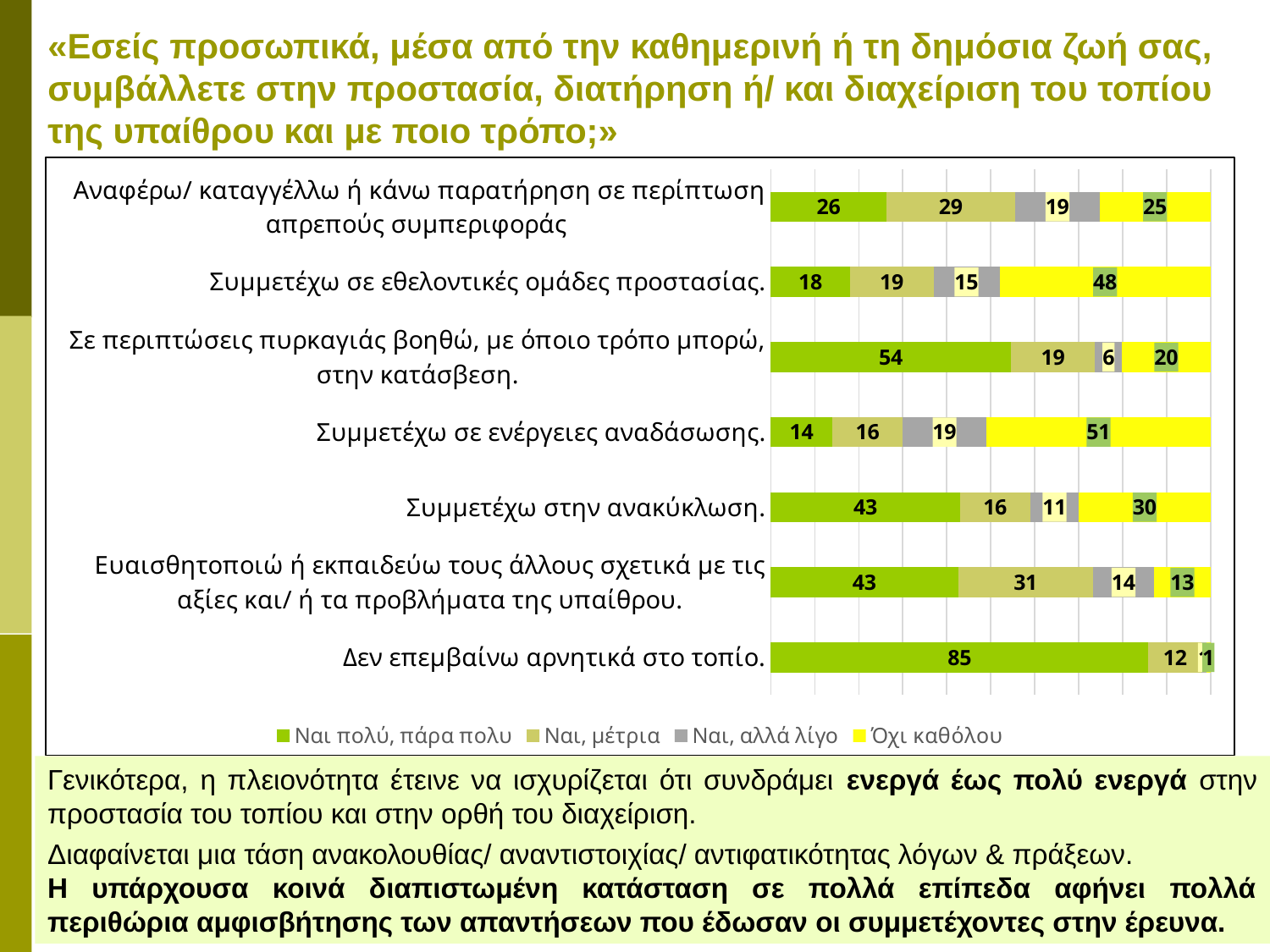
Which is larger: the "Όχι καθόλου" value for "Συμμετέχω σε εθελοντικές ομάδες προστασίας." or for "Συμμετέχω στην ανακύκλωση."? Συμμετέχω σε εθελοντικές ομάδες προστασίας. What kind of chart is shown on the slide? Stacked bar chart What is the value of "Ναι, μέτρια" for "Ευαισθητοποιώ ή εκπαιδεύω τους άλλους σχετικά με τις αξίες και/ ή τα προβλήματα της υπαίθρου."? 31 What is the value of "Όχι καθόλου" for "Συμμετέχω σε ενέργειες αναδάσωσης."? 51 What is the difference between the "Ναι πολύ, πάρα πολυ" values for "Σε περιπτώσεις πυρκαγιάς βοηθώ, με όποιο τρόπο μπορώ, στην κατάσβεση." and "Συμμετέχω σε ενέργειες αναδάσωσης."? 40 What is the value of "Ναι, αλλά λίγο" for "Σε περιπτώσεις πυρκαγιάς βοηθώ, με όποιο τρόπο μπορώ, στην κατάσβεση."? 6 How many categories (statements) are plotted in the chart? 7 What is the first entry in the chart legend? Ναι πολύ, πάρα πολυ How many series does the chart legend list? 4 Which category has the highest value for "Ναι πολύ, πάρα πολυ"? Δεν επεμβαίνω αρνητικά στο τοπίο. Which category has the lowest value for "Ναι πολύ, πάρα πολυ"? Συμμετέχω σε ενέργειες αναδάσωσης. What is the value of "Ναι πολύ, πάρα πολυ" for "Δεν επεμβαίνω αρνητικά στο τοπίο."? 85